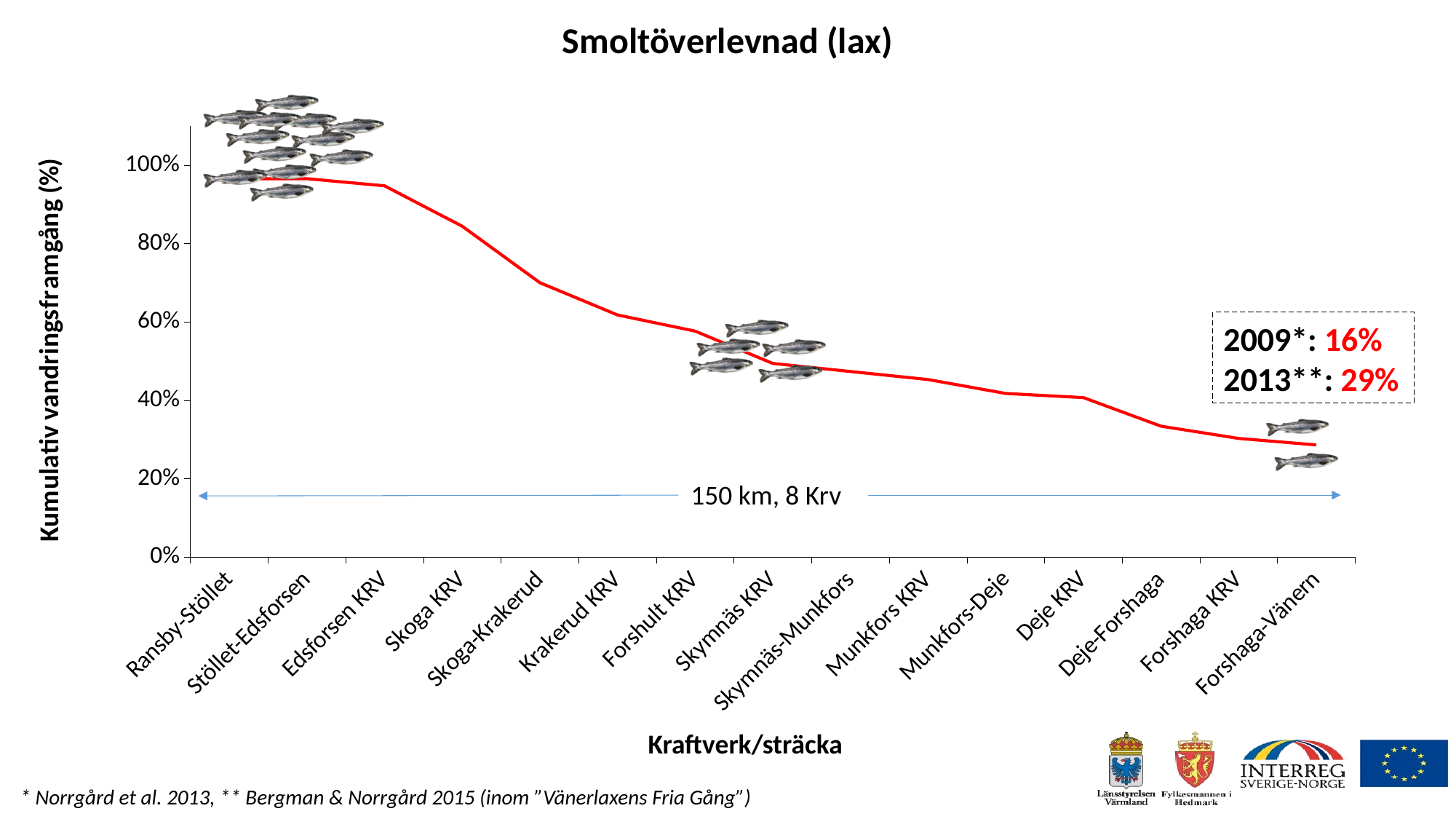
Is the value for Munkfors-Deje greater or less than 60%? less How many categories are shown on the x axis? 15 What is the title of the chart? Smoltöverlevnad (lax) Is the value for Deje-Forshaga greater or less than 40%? less What is the label of the y axis? Kumulativ vandringsframgång (%) Is the value for Forshaga-Vänern greater or less than 40%? less Which category has the lowest value? Forshaga-Vänern Do the values rise or fall along the x axis from Ransby-Stöllet to Forshaga-Vänern? fall What kind of chart is shown on the slide? line chart Which is larger, the value for Edsforsen KRV or the value for Skymnäs KRV? Edsforsen KRV